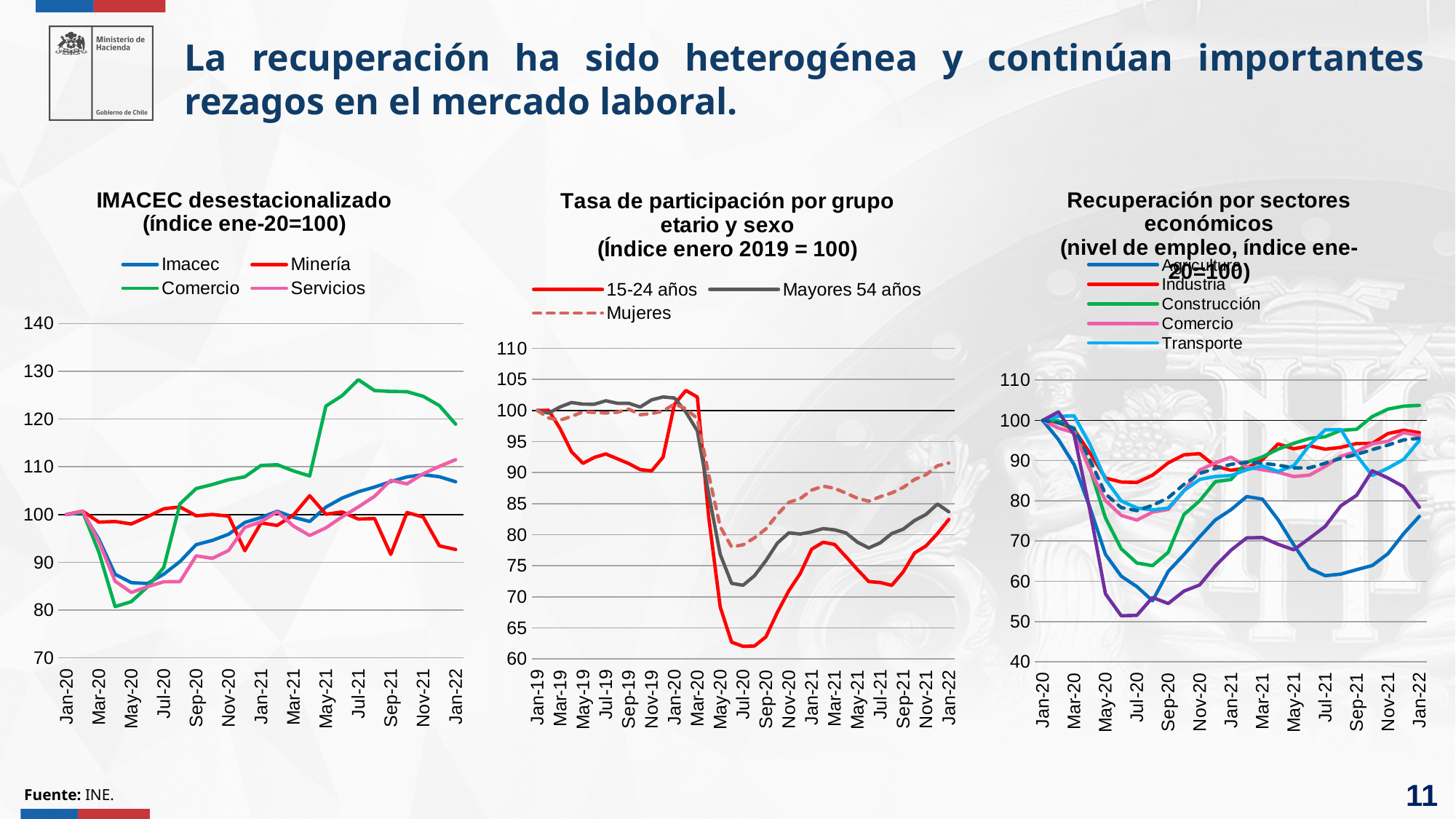
How many series does the legend of the 'Tasa de participación por grupo etario y sexo' chart list? 3 In the 'IMACEC desestacionalizado' chart, is the value for Minería in Jan-22 greater or less than 100? less In the 'IMACEC desestacionalizado' chart, which series is higher in Jul-21, Comercio or Minería? Comercio In the 'Tasa de participación por grupo etario y sexo' chart, which series is higher in Jul-20, 15-24 años or Mujeres? Mujeres Which series in the 'Tasa de participación por grupo etario y sexo' chart is drawn with a dashed line? Mujeres What kind of chart is the 'IMACEC desestacionalizado' chart on the left? line chart In the 'Recuperación por sectores económicos' chart, is the value for Construcción in Jan-22 greater or less than 100? greater In the 'IMACEC desestacionalizado' chart, is the value for Comercio in Jul-21 greater or less than 120? greater How many series does the legend of the 'IMACEC desestacionalizado' chart list? 4 In the 'Tasa de participación por grupo etario y sexo' chart, does the 15-24 años series rise or fall from Jul-20 to Jan-22? rise